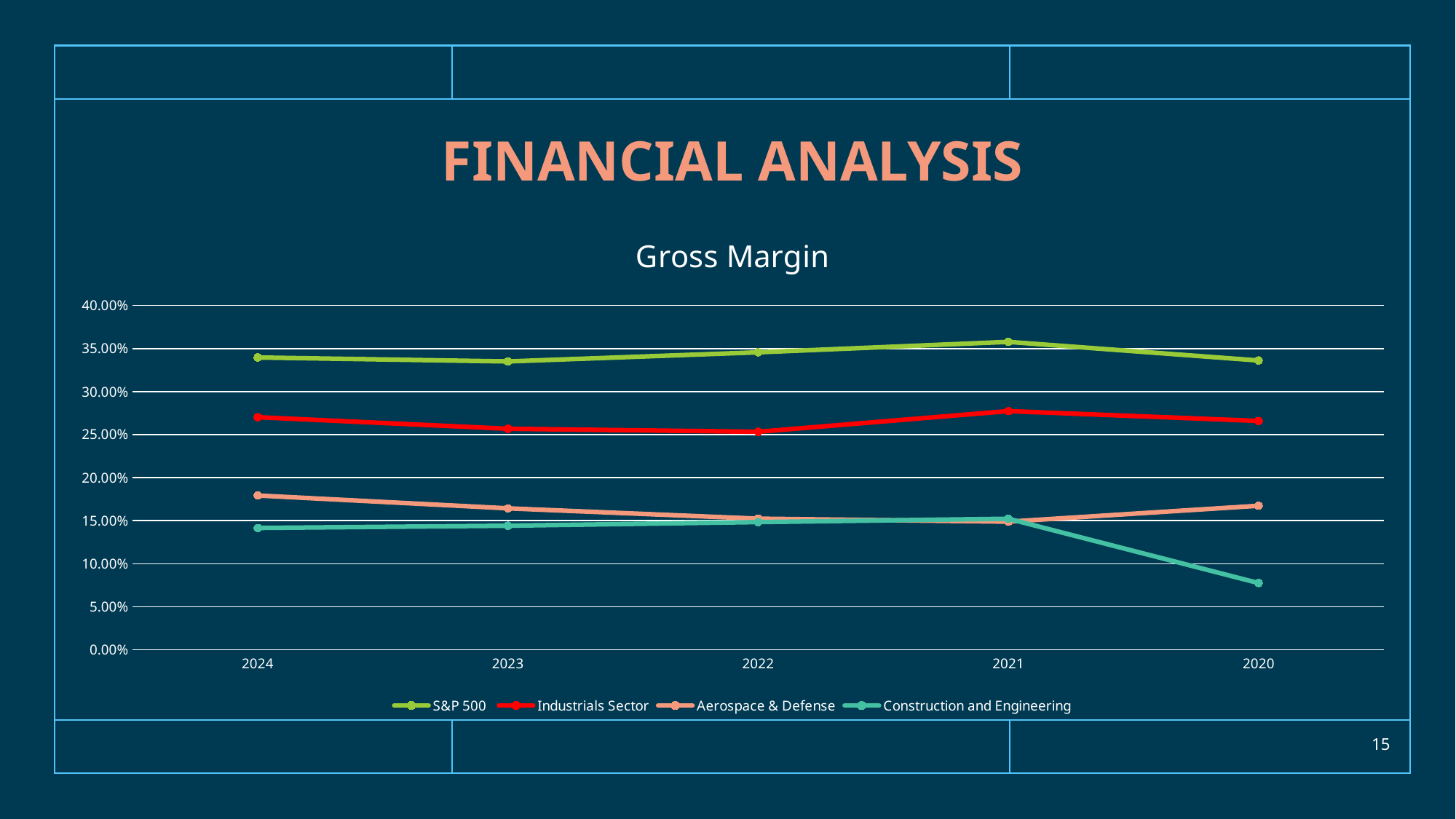
Is the value for S&P 500 in 2021 greater or less than 30.00%? greater What kind of chart is shown on the slide? line chart In which year is the S&P 500 gross margin highest? 2021 In 2020, which is larger: Aerospace & Defense or Construction and Engineering? Aerospace & Defense Is the value for Aerospace & Defense in 2024 greater or less than 20.00%? less Does the Construction and Engineering line rise or fall between 2021 and 2020? fall What is the title of the chart? Gross Margin How many series does the legend list? 4 How many years are shown on the x axis? 5 Which series has the lowest gross margin in 2020? Construction and Engineering Which series has the highest gross margin in 2024? S&P 500 Is the value for Construction and Engineering in 2020 greater or less than 10.00%? less